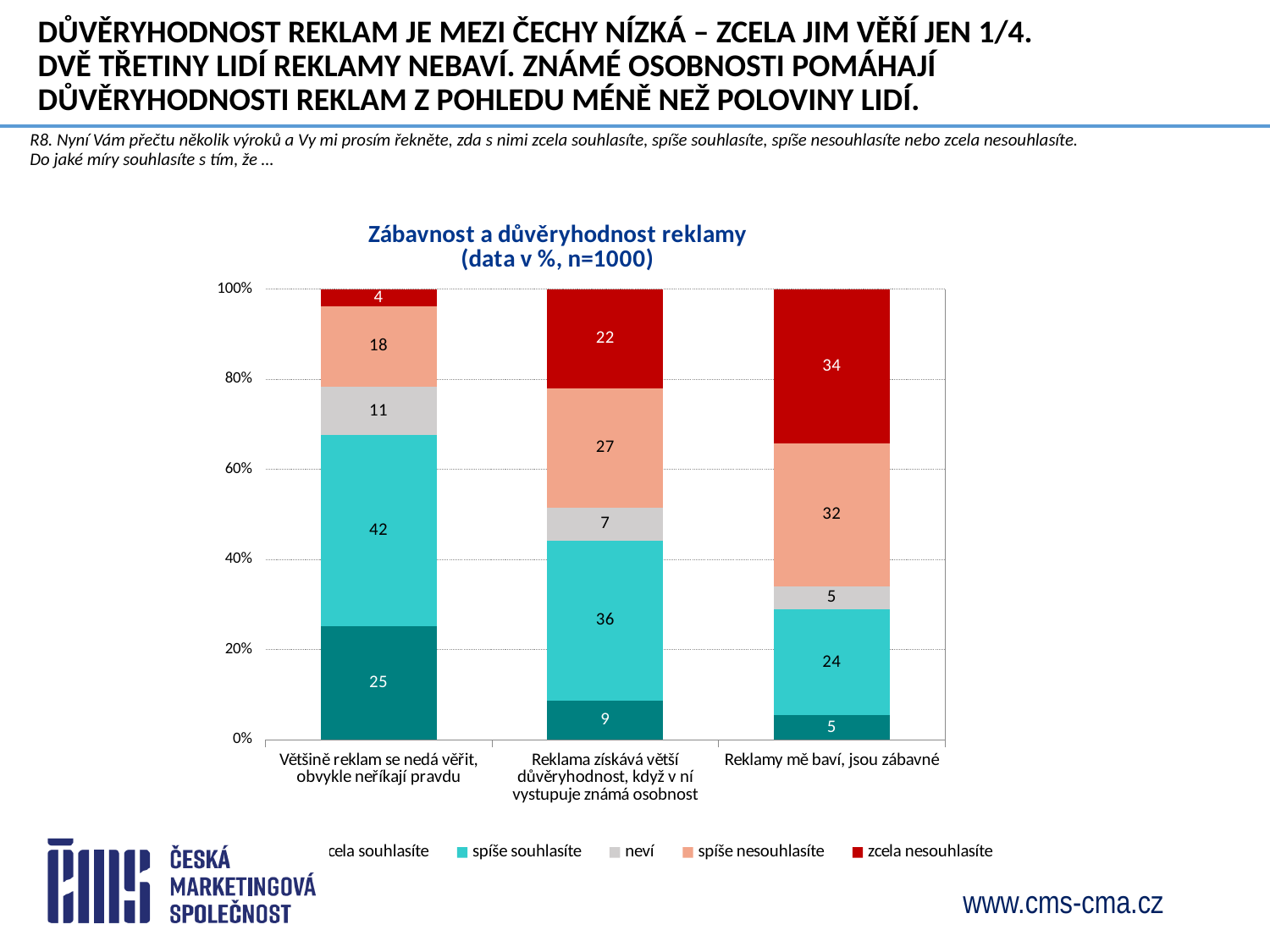
What is the difference between the 'spíše nesouhlasíte' values for 'Reklamy mě baví, jsou zábavné' and 'Většině reklam se nedá věřit, obvykle neříkají pravdu'? 14 What is the value of 'spíše souhlasíte' for 'Většině reklam se nedá věřit, obvykle neříkají pravdu'? 42 What kind of chart is shown on the slide? stacked bar chart Which is larger: 'zcela nesouhlasíte' for 'Reklama získává větší důvěryhodnost, když v ní vystupuje známá osobnost' or 'spíše nesouhlasíte' for the same statement? spíše nesouhlasíte Which statement has the lowest value for 'spíše souhlasíte'? Reklamy mě baví, jsou zábavné What is the title of the chart? Zábavnost a důvěryhodnost reklamy (data v %, n=1000) What is the value of 'zcela nesouhlasíte' for 'Reklamy mě baví, jsou zábavné'? 34 Which statement has the highest value for 'zcela nesouhlasíte'? Reklamy mě baví, jsou zábavné What is the value of 'neví' for 'Reklama získává větší důvěryhodnost, když v ní vystupuje známá osobnost'? 7 What is the value of 'spíše nesouhlasíte' for 'Reklamy mě baví, jsou zábavné'? 32 How many categories (statements) are shown on the x axis of the chart? 3 How many series does the legend of the chart list? 5